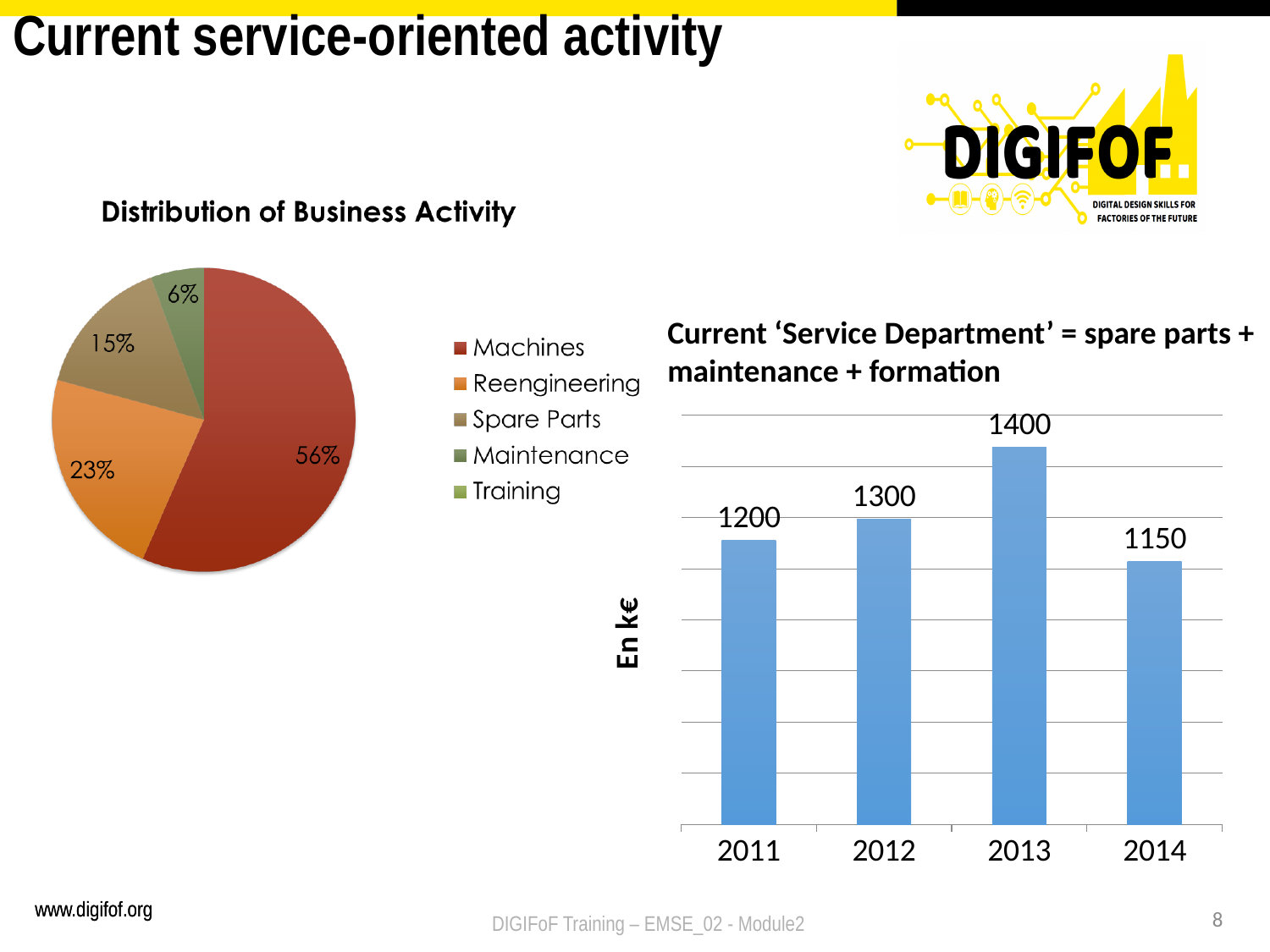
In the pie chart titled 'Distribution of Business Activity', how many entries does the legend list? 5 In the pie chart titled 'Distribution of Business Activity', what share does Spare Parts have? 15% In the pie chart titled 'Distribution of Business Activity', what share does Machines have? 56% In the bar chart on the right side of the slide, which year has the lowest value? 2014 In the pie chart titled 'Distribution of Business Activity', what share does Reengineering have? 23% In the bar chart on the right side of the slide, what is the difference between the values for 2013 and 2011? 200 What kind of chart is the chart on the right side of the slide, below the text 'Current Service Department'? Bar chart In the pie chart titled 'Distribution of Business Activity', what is the difference between the Machines share and the Reengineering share? 33% In the bar chart on the right side of the slide, what is the value for 2014? 1150 In the bar chart on the right side of the slide, what is the value for 2013? 1400 In the bar chart on the right side of the slide, what is the label on the vertical axis? En k€ In the pie chart titled 'Distribution of Business Activity', which category has the largest share? Machines